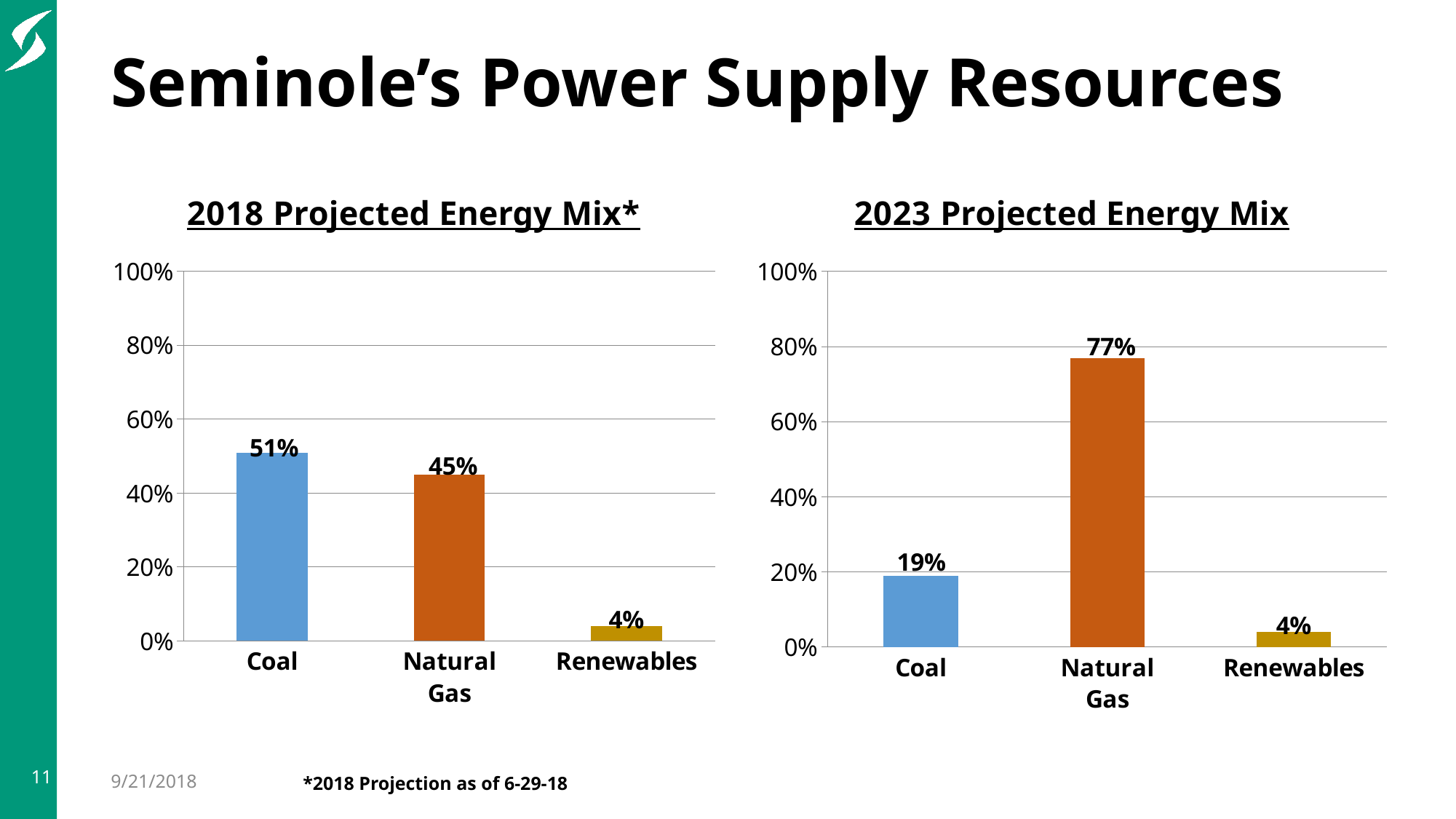
In the 2023 Projected Energy Mix chart, what is the value for Natural Gas? 77% In the 2023 Projected Energy Mix chart, what is the difference between the Natural Gas and Coal values? 58% What is the title of the chart on the right side of the slide? 2023 Projected Energy Mix In the 2018 Projected Energy Mix chart, is the value for Natural Gas greater or less than 40%? greater In the 2023 Projected Energy Mix chart, which is larger, Coal or Natural Gas? Natural Gas In the 2018 Projected Energy Mix chart, what is the difference between the Coal and Natural Gas values? 6% In the 2023 Projected Energy Mix chart, which category has the lowest value? Renewables How many categories are shown in the 2023 Projected Energy Mix chart? 3 What kind of chart is the 2018 Projected Energy Mix chart? Bar chart In the 2018 Projected Energy Mix chart, what is the value for Coal? 51% In the 2018 Projected Energy Mix chart, which category has the highest value? Coal In the 2023 Projected Energy Mix chart, what is the value for Coal? 19%